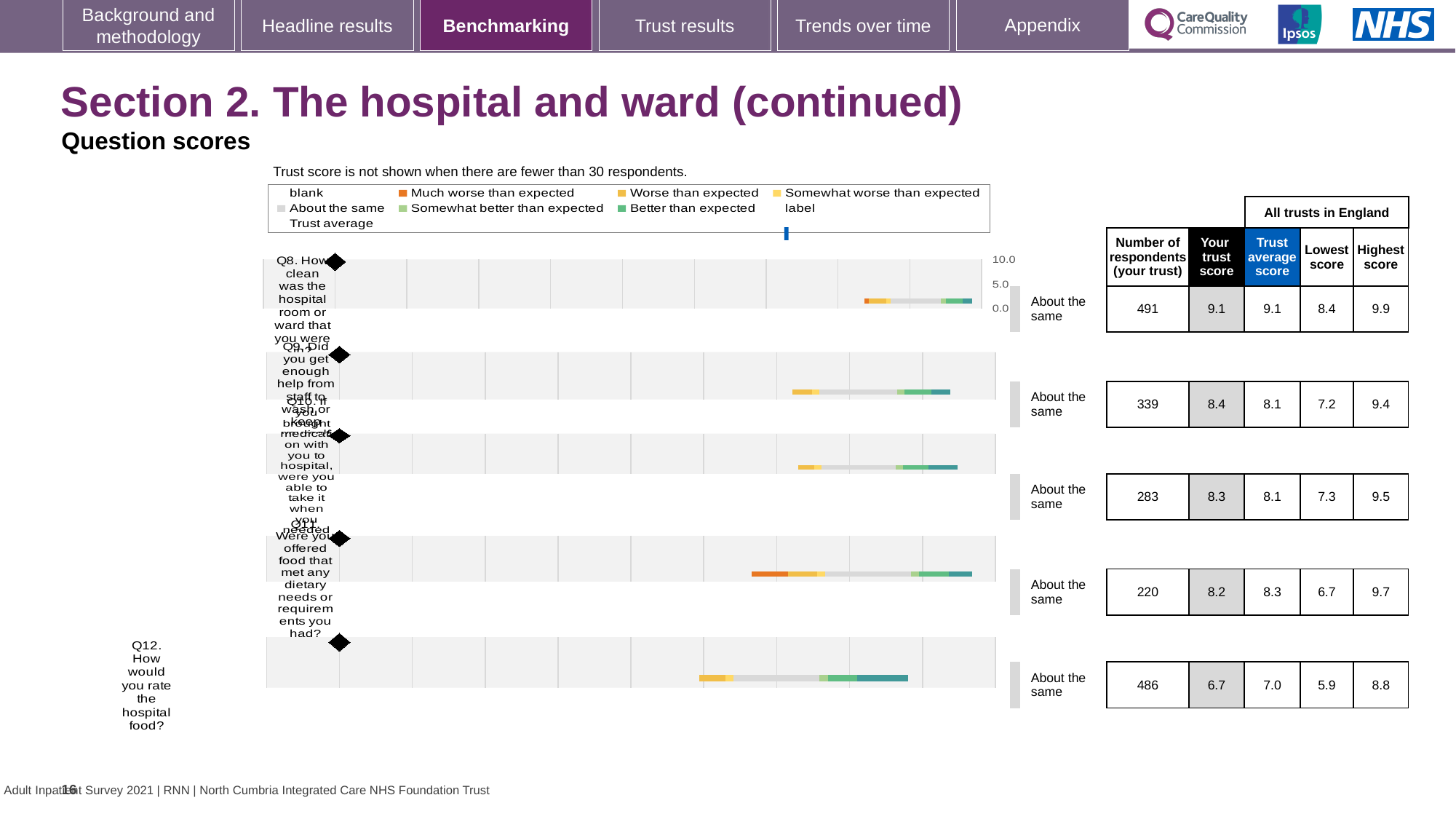
In the legend, which category is shown in dark orange? Much worse than expected What kind of chart is used to show the question scores on this slide? bar chart What is the trust score for Q8, how clean was the hospital room or ward? 9.1 Which question has the highest 'Your trust score' in the table? Q8 For Q12, what is the difference between the highest score and the lowest score across all trusts in England? 2.9 What benchmark category is shown for Q12 in the chart? About the same For Q9, which is larger: the trust score or the trust average score? the trust score (8.4) What is the number of respondents (your trust) for Q12, how would you rate the hospital food? 486 Which question has the lowest 'Your trust score' in the table? Q12 What is the number of respondents (your trust) for Q10, about taking medication brought to hospital? 283 How many questions (categories) are plotted in the chart? 5 What is the lowest score across all trusts in England for Q11, about food meeting dietary needs? 6.7